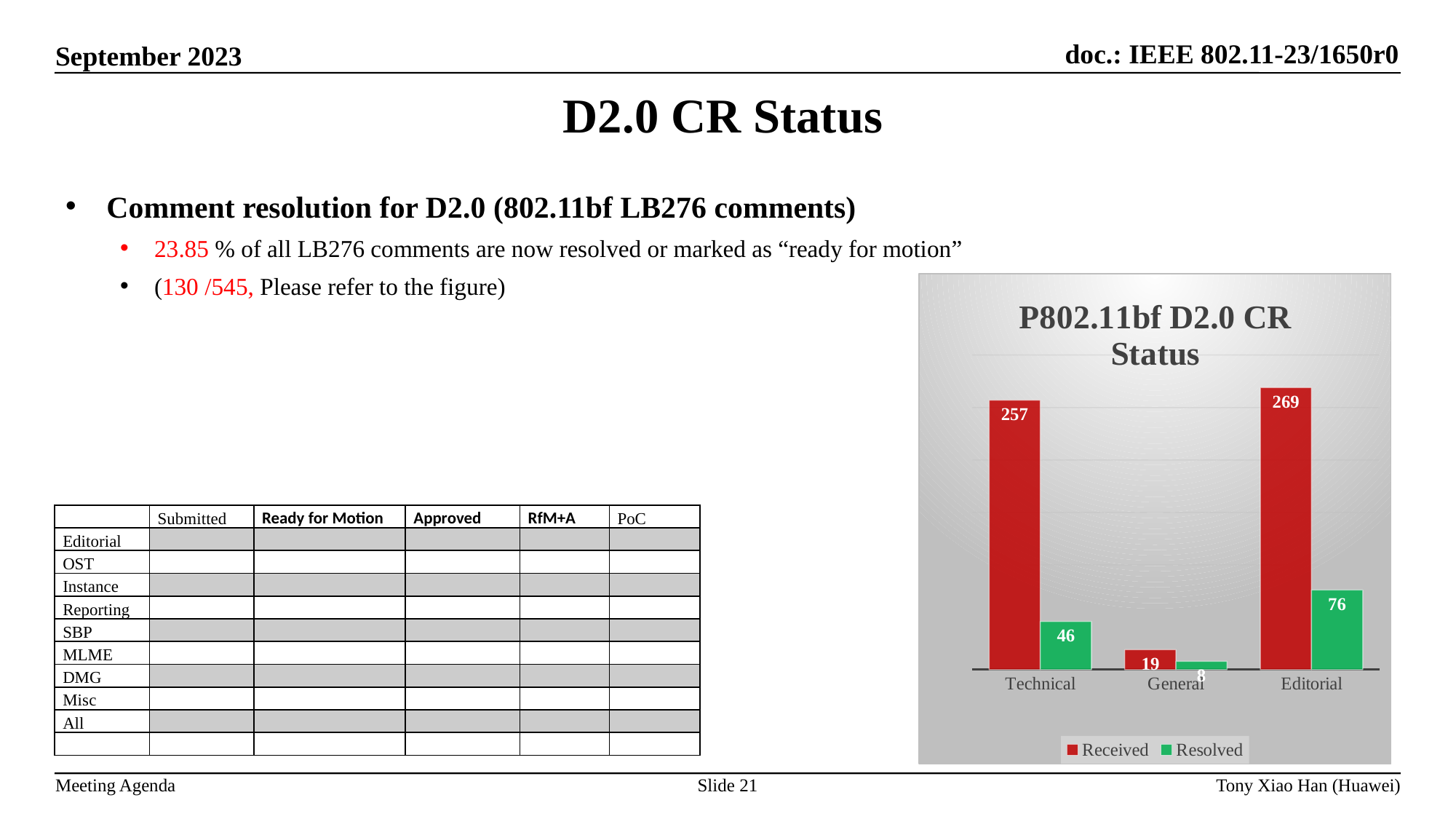
How many categories are shown on the x axis of the chart? 3 Which category has the lowest Resolved value? General How many series does the chart legend list? 2 Which category has the highest Received value? Editorial What is the Received value for Technical? 257 What is the Received value for General? 19 What type of chart is shown on the slide? bar chart What is the Resolved value for Technical? 46 Which is larger, the Resolved value for Technical or the Resolved value for Editorial? Editorial What is the title of the chart? P802.11bf D2.0 CR Status What is the difference between the Received and Resolved values for Editorial? 193 What is the Resolved value for Editorial? 76